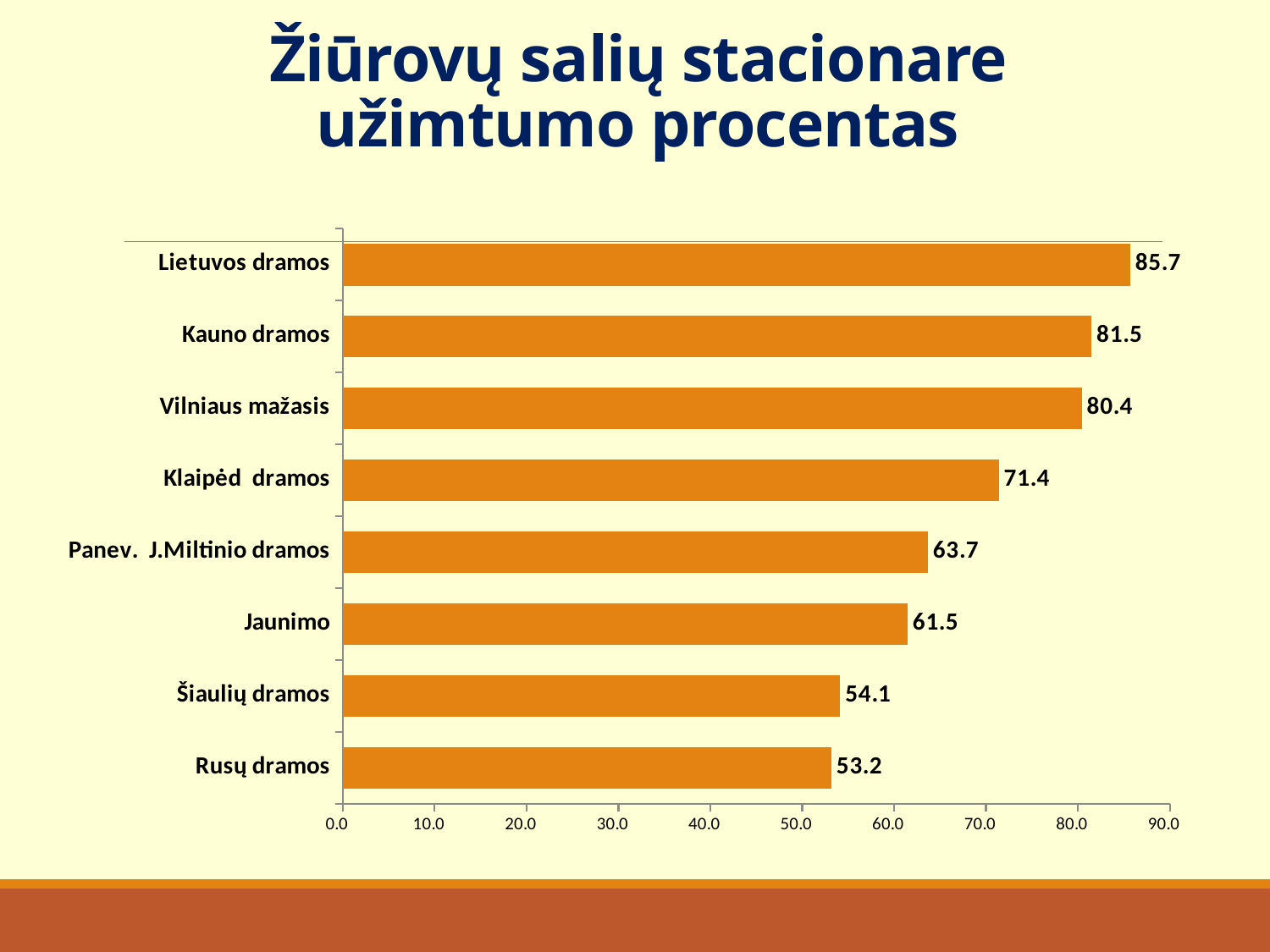
What is the value for Klaipėd dramos? 71.4 What is the title of the slide? Žiūrovų salių stacionare užimtumo procentas What is the value for Jaunimo? 61.5 What is the value for Lietuvos dramos? 85.7 Is the value for Šiaulių dramos greater or less than 60.0? less Which category has the lowest value? Rusų dramos What kind of chart is shown on the slide? bar chart Which is larger, the value for Panev. J.Miltinio dramos or the value for Šiaulių dramos? Panev. J.Miltinio dramos What is the difference between the values for Kauno dramos and Vilniaus mažasis? 1.1 Which category has the highest value? Lietuvos dramos How many categories are shown in the chart? 8 What is the difference between the values for Lietuvos dramos and Rusų dramos? 32.5